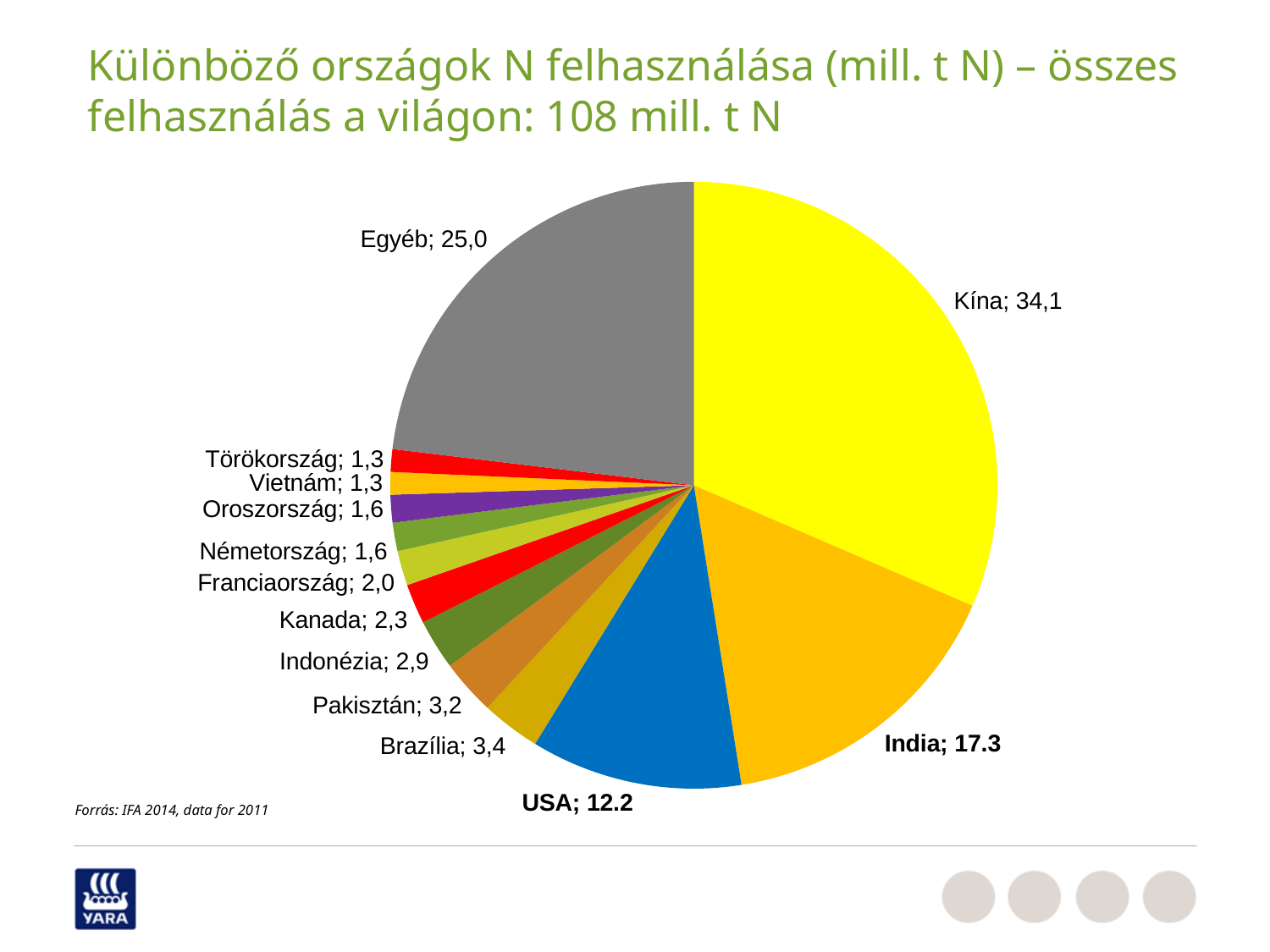
What is the difference between the values for Kína and India? 16,8 Which is larger, the value for India or the value for USA? India What is the value shown for Kína? 34,1 Which slice of the pie has the largest value? Kína How many slices does the pie chart have? 13 What is the value shown for Pakisztán? 3,2 What kind of chart is shown on the slide? pie chart What is the value shown for USA? 12.2 What is the value shown for Egyéb? 25,0 What is the value shown for India? 17.3 What is the difference between the values for Egyéb and USA? 12,8 According to the slide title, what is the total N use in the world? 108 mill. t N